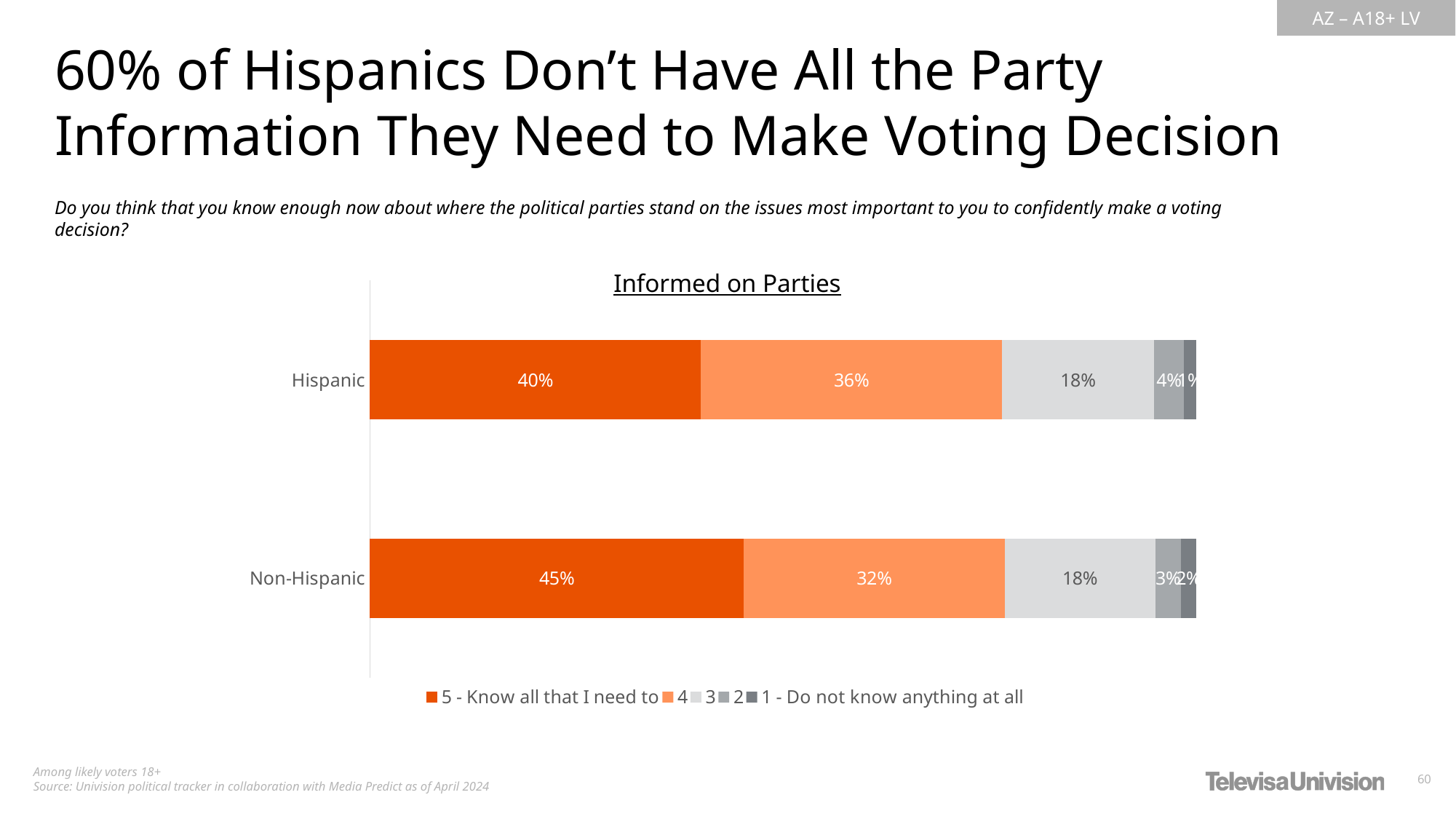
What percentage of Non-Hispanic respondents say they "Know all that I need to" (5)? 45% What kind of chart is shown on the slide? Stacked bar chart How many groups (categories) are shown on the chart? 2 Which group has the larger share rating 5 - Know all that I need to, Hispanic or Non-Hispanic? Non-Hispanic What is the difference between the Non-Hispanic and Hispanic shares for 5 - Know all that I need to? 5 percentage points How many series does the legend list? 5 What percentage of Hispanic respondents say they "Do not know anything at all" (1)? 1% What percentage of Hispanic respondents gave a rating of 4? 36% What is the title of the chart? Informed on Parties What percentage of Non-Hispanic respondents gave a rating of 3? 18% What is the difference between the Hispanic and Non-Hispanic shares for rating 4? 4 percentage points What percentage of Hispanic respondents say they "Know all that I need to" (5)? 40%